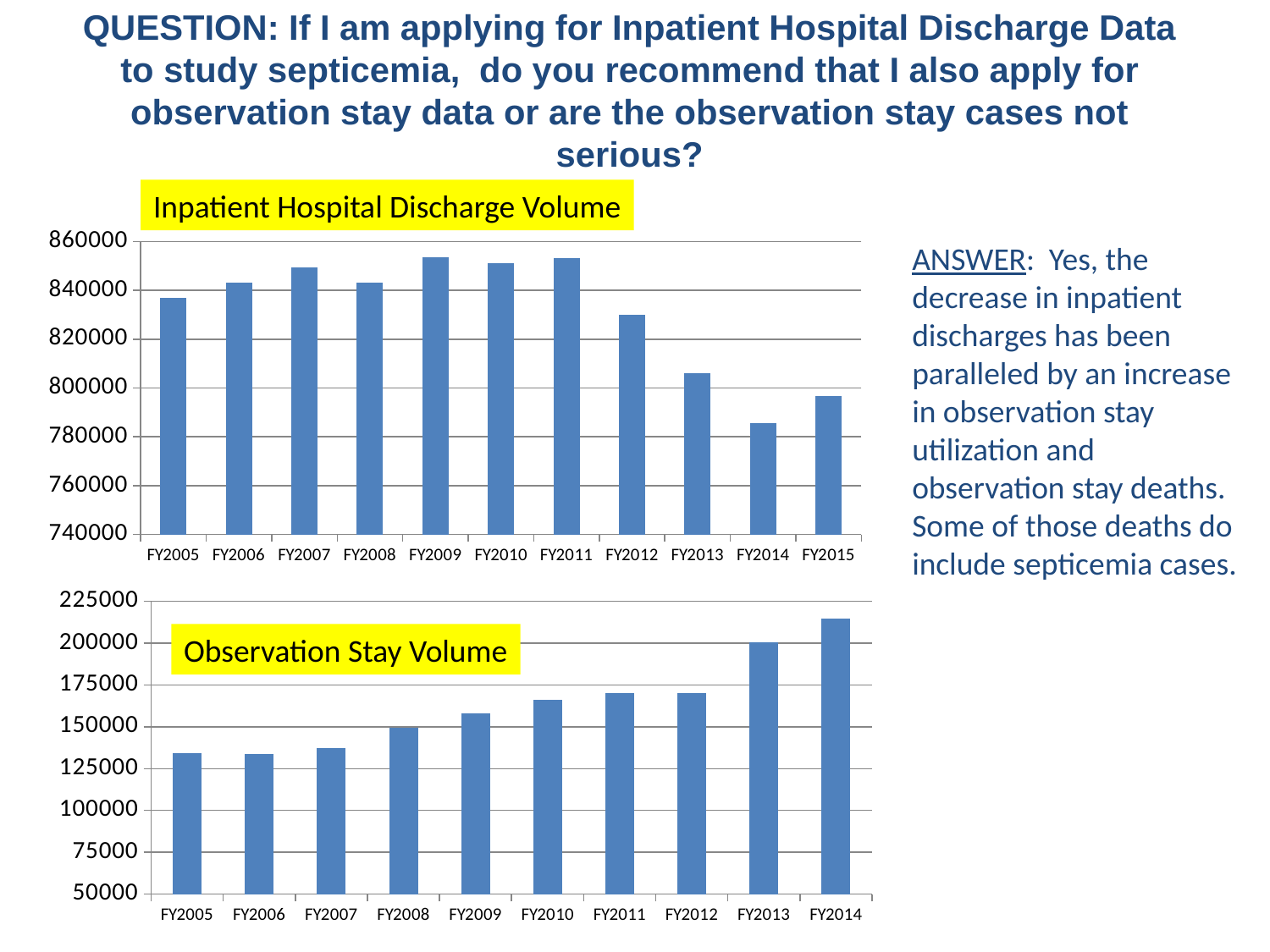
How many fiscal years are shown on the x axis of the Observation Stay Volume chart? 10 In the Observation Stay Volume chart, do the values generally rise or fall from FY2005 to FY2014? rise In the Observation Stay Volume chart, is the value for FY2014 greater or less than 200000? greater How many fiscal years are shown on the x axis of the Inpatient Hospital Discharge Volume chart? 11 In the Observation Stay Volume chart, which fiscal year has the highest value? FY2014 In the Inpatient Hospital Discharge Volume chart, is the value for FY2012 greater or less than 820000? greater In the Inpatient Hospital Discharge Volume chart, which fiscal year has the lowest value? FY2014 In the Observation Stay Volume chart, is the value for FY2010 greater or less than 175000? less What type of chart is the Inpatient Hospital Discharge Volume chart? bar chart In the Inpatient Hospital Discharge Volume chart, do the values rise or fall from FY2011 to FY2014? fall In the Inpatient Hospital Discharge Volume chart, which is larger, the value for FY2011 or the value for FY2015? FY2011